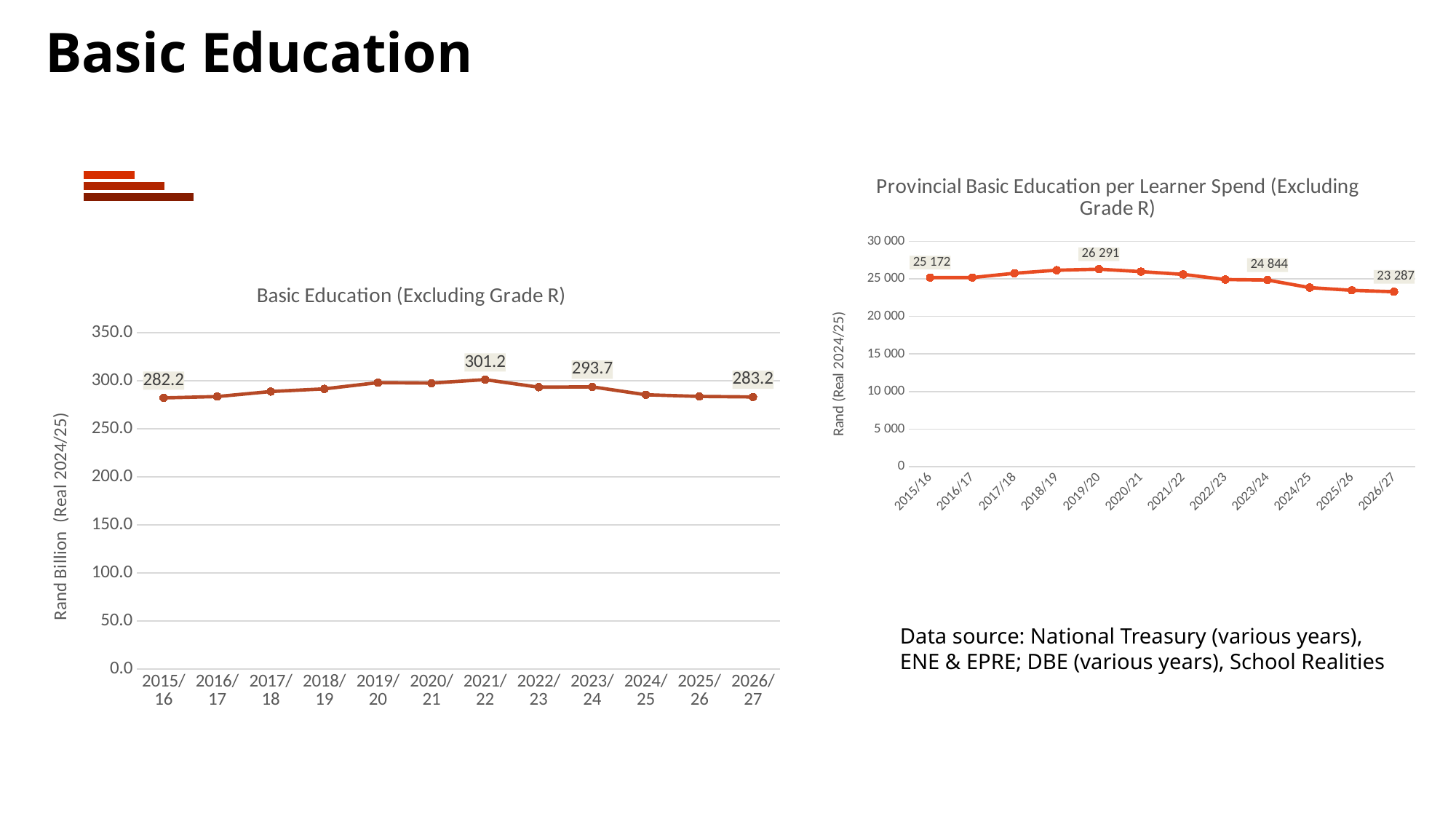
What kind of chart is the chart titled "Provincial Basic Education per Learner Spend (Excluding Grade R)"? Line chart In the chart titled "Basic Education (Excluding Grade R)", what is the difference between the 2021/22 value and the 2015/16 value? 19.0 In the chart titled "Provincial Basic Education per Learner Spend (Excluding Grade R)", what is the value for 2026/27? 23 287 In the chart titled "Basic Education (Excluding Grade R)", what is the value for 2023/24? 293.7 In the chart titled "Basic Education (Excluding Grade R)", is the value for 2024/25 greater or less than 250.0? greater In the chart titled "Provincial Basic Education per Learner Spend (Excluding Grade R)", is the value for 2024/25 greater or less than 25 000? less In the chart titled "Provincial Basic Education per Learner Spend (Excluding Grade R)", how many years are plotted on the x axis? 12 In the chart titled "Basic Education (Excluding Grade R)", which year has the highest value? 2021/22 In the chart titled "Provincial Basic Education per Learner Spend (Excluding Grade R)", what is the value for 2019/20? 26 291 In the chart titled "Basic Education (Excluding Grade R)", what is the value for 2015/16? 282.2 In the chart titled "Basic Education (Excluding Grade R)", what is the value for 2021/22? 301.2 In the chart titled "Provincial Basic Education per Learner Spend (Excluding Grade R)", which year has the lowest value? 2026/27